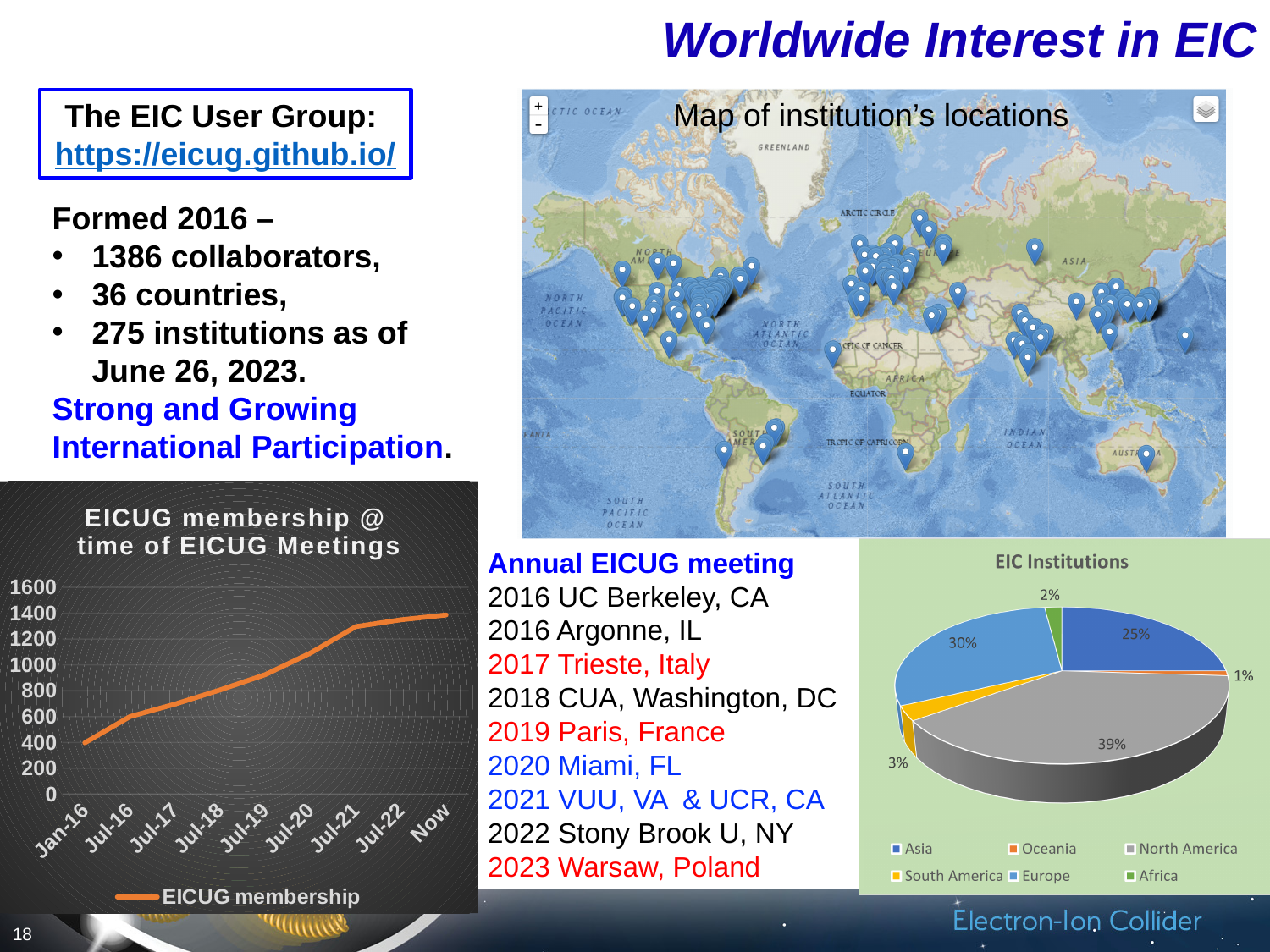
How many regions does the legend of the 'EIC Institutions' pie chart list? 6 In the 'EIC Institutions' pie chart, what share of institutions is in North America? 39% In the 'EIC Institutions' pie chart, what share of institutions is in Europe? 30% What kind of chart is 'EICUG membership @ time of EICUG Meetings'? Line chart In the 'EIC Institutions' pie chart, which has the larger share, Asia or Europe? Europe In the 'EICUG membership @ time of EICUG Meetings' chart, is the value for Jul-17 greater or less than 1000? less In the 'EIC Institutions' pie chart, which region has the largest share? North America In the 'EIC Institutions' pie chart, which region has the smallest share? Oceania In the 'EICUG membership @ time of EICUG Meetings' chart, is the value for Now greater or less than 1200? greater In the 'EICUG membership @ time of EICUG Meetings' chart, does membership rise or fall from Jan-16 to Now? Rise In the 'EIC Institutions' pie chart, how many percentage points larger is North America's share than Europe's? 9% In the 'EIC Institutions' pie chart, what share of institutions is in Asia? 25%